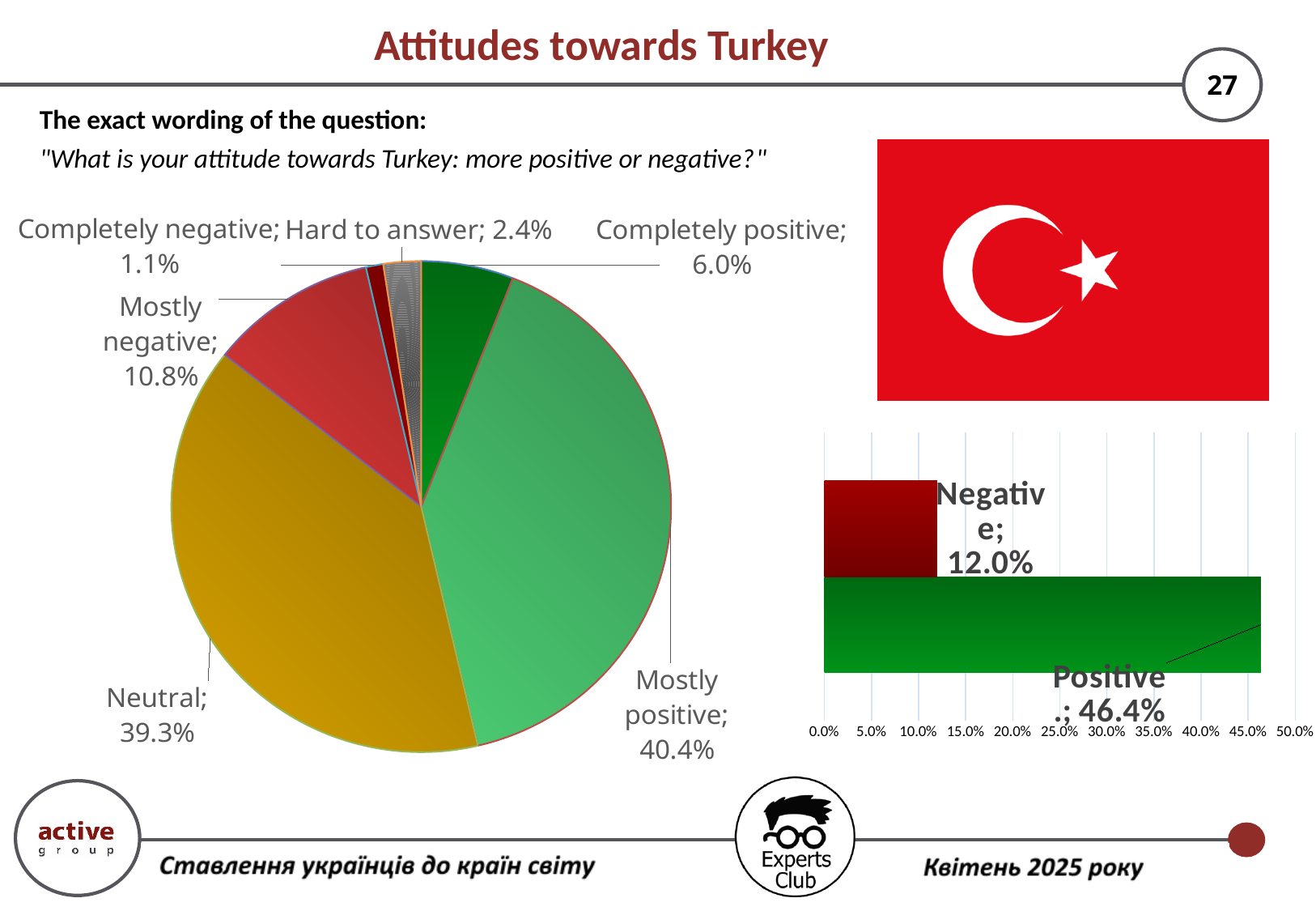
In the bar chart on the right, what is the value for "Positive"? 46.4% In the pie chart, how many categories are shown? 6 In the pie chart, what share of respondents answered "Hard to answer"? 2.4% In the bar chart on the right, what is the value for "Negative"? 12.0% In the bar chart on the right, what is the difference between the "Positive" and "Negative" values? 34.4 percentage points In the pie chart, what is the difference between the "Mostly negative" and "Completely positive" shares? 4.8 percentage points In the pie chart, what share of respondents answered "Neutral"? 39.3% What type of chart is shown on the right side of the slide? Bar chart In the pie chart, which category has the largest share? Mostly positive In the pie chart, what share of respondents answered "Completely negative"? 1.1% In the pie chart, what share of respondents answered "Mostly positive"? 40.4% In the pie chart, which category has the smallest share? Completely negative